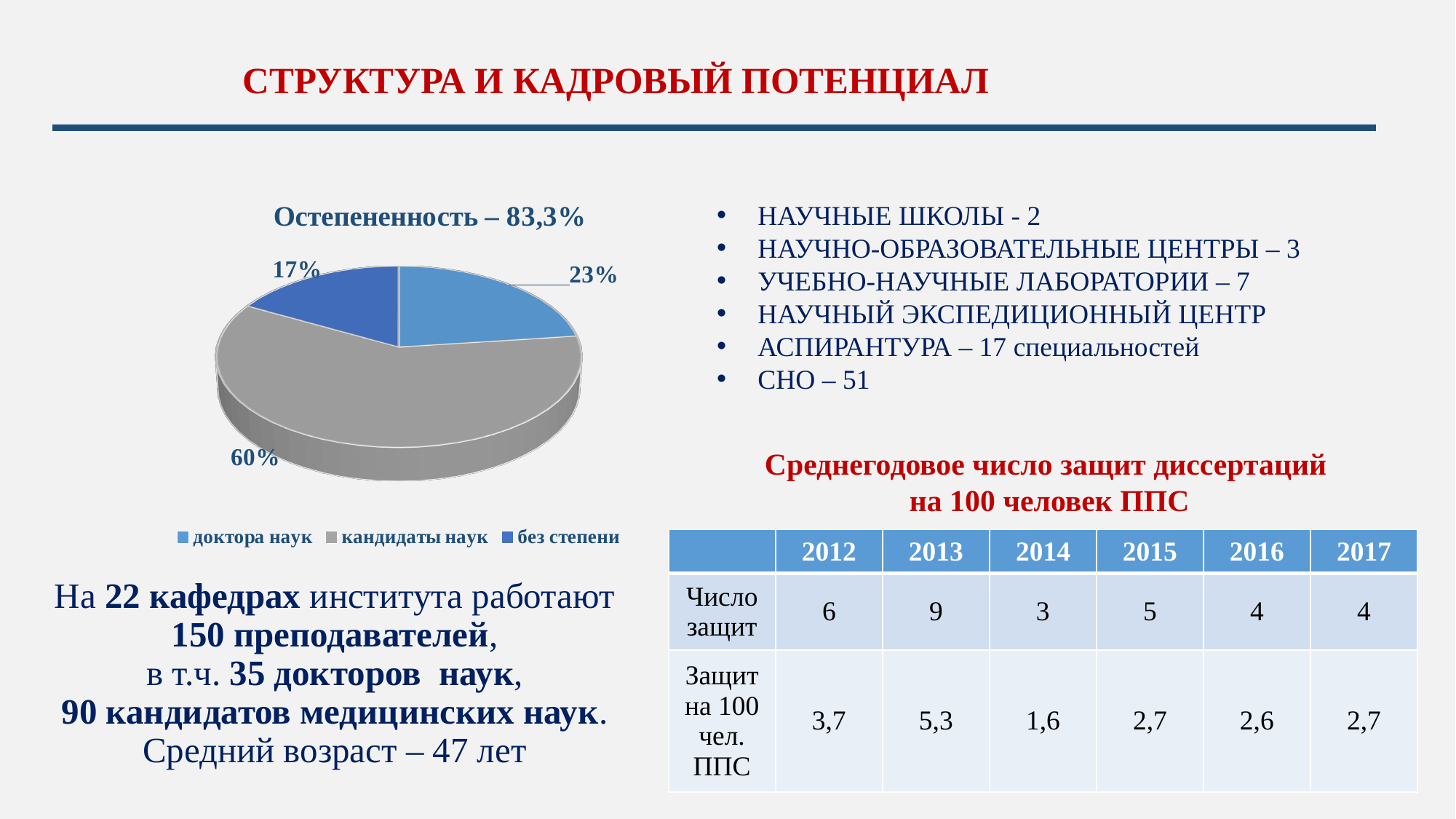
What share of the pie chart is labelled "без степени"? 17% What share of the pie chart is labelled "кандидаты наук"? 60% What share of the pie chart is labelled "доктора наук"? 23% Which category has the largest slice in the pie chart? кандидаты наук What is the combined share of the "доктора наук" and "кандидаты наук" slices? 83% What is the difference in percentage points between the "кандидаты наук" slice and the "доктора наук" slice? 37 What kind of chart is shown on the slide? pie chart How many entries does the pie chart legend list? 3 What is the title of the pie chart? Остепененность – 83,3% Which category has the smallest slice in the pie chart? без степени How many slices does the pie chart have? 3 Which slice is larger in the pie chart: "доктора наук" or "без степени"? доктора наук